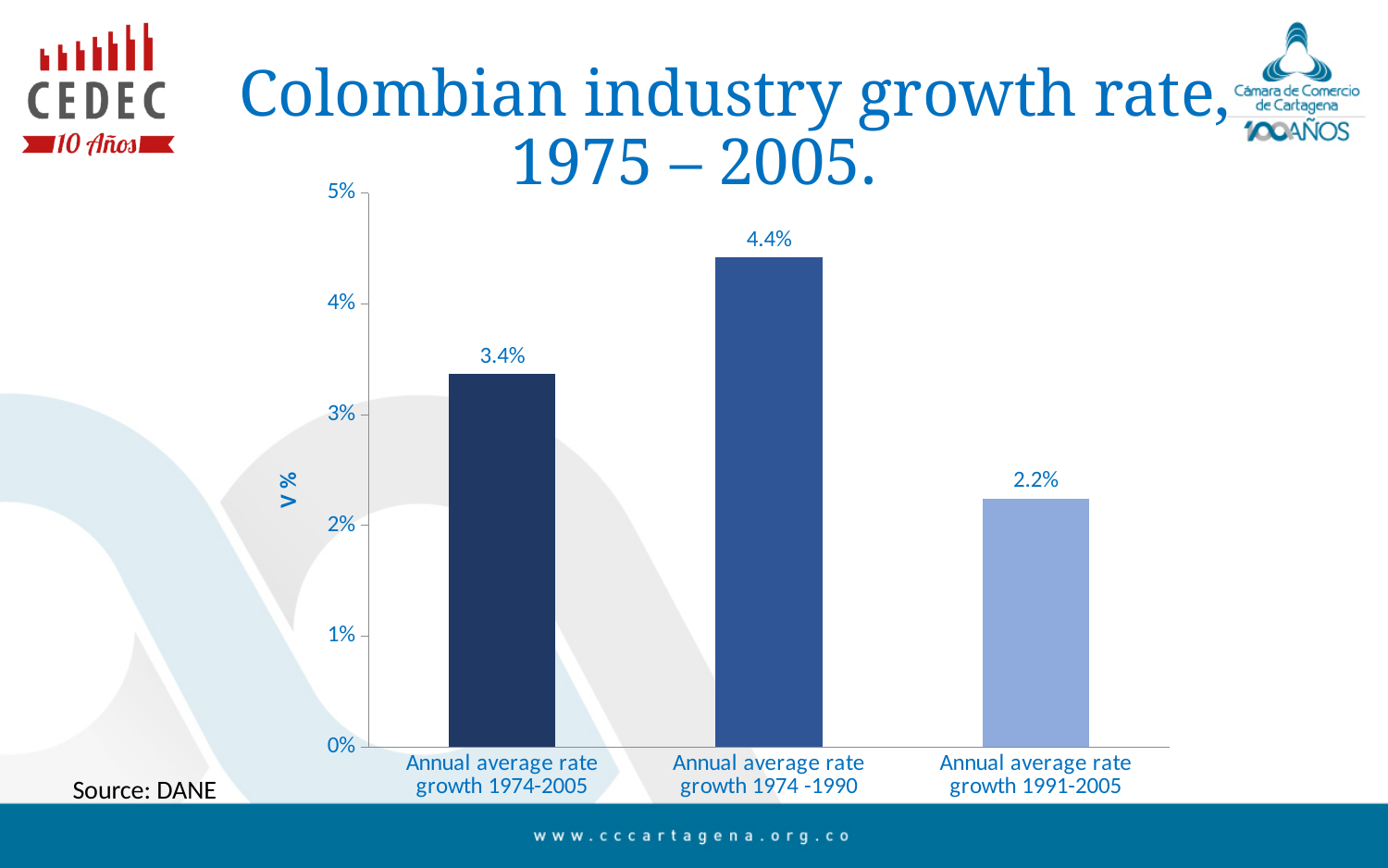
What is the annual average rate growth for 1974-1990? 4.4% Which period has the highest annual average growth rate? Annual average rate growth 1974-1990 What is the annual average rate growth for 1991-2005? 2.2% What is the difference between the growth rate for 1974-1990 and the growth rate for 1974-2005? 1.0% How many bars are shown in the chart? 3 What is the difference between the growth rate for 1974-1990 and the growth rate for 1991-2005? 2.2% What is the title of the chart? Colombian industry growth rate, 1975 – 2005. Which is larger, the growth rate for 1974-2005 or the growth rate for 1991-2005? Annual average rate growth 1974-2005 What kind of chart is shown on the slide? Bar chart What is the annual average rate growth for 1974-2005? 3.4% Is the value for annual average rate growth 1974-1990 greater or less than 4%? greater Which period has the lowest annual average growth rate? Annual average rate growth 1991-2005